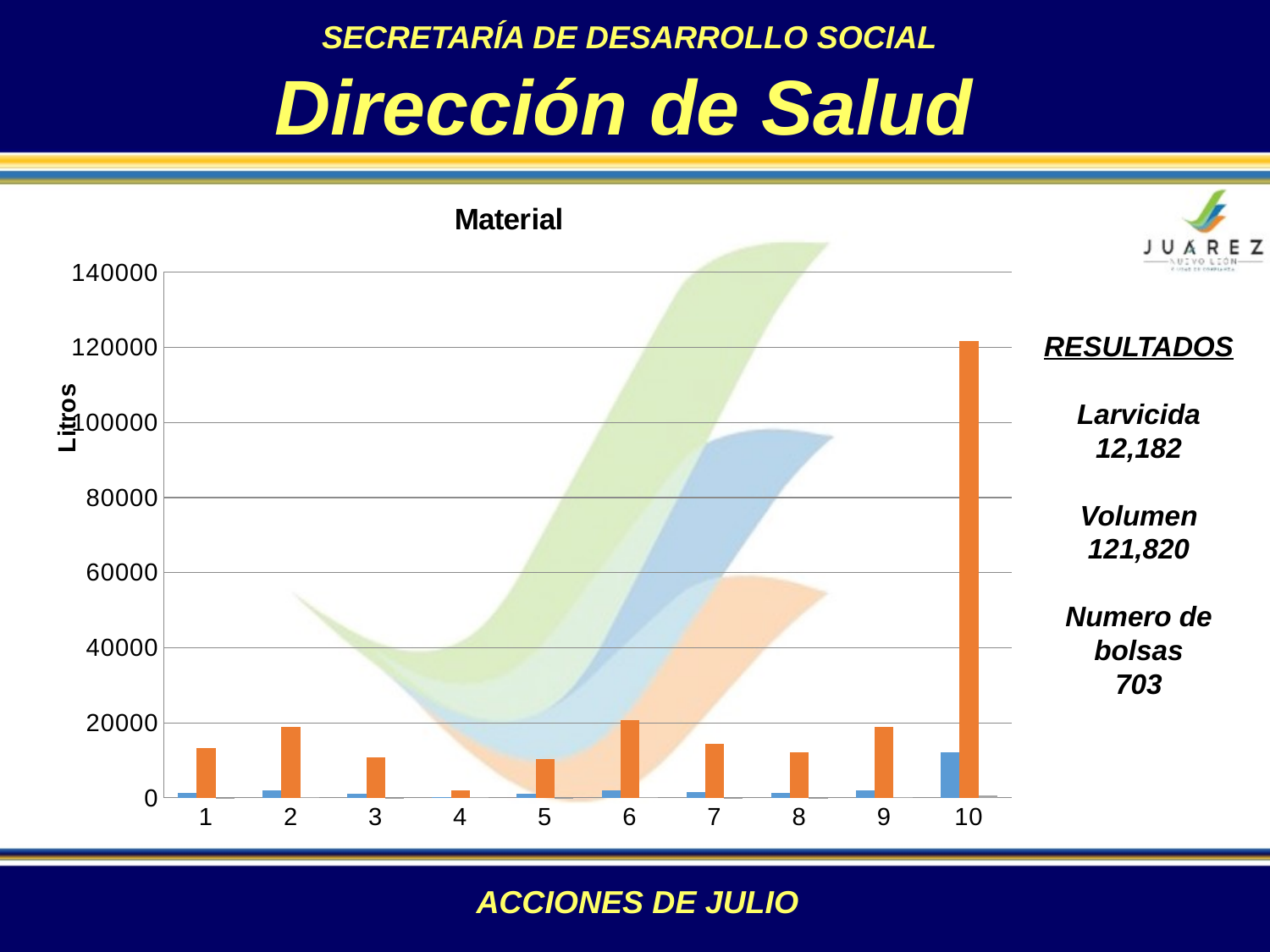
Which is larger, the orange bar for category 2 or the orange bar for category 4? category 2 Which category has the tallest blue bar? 10 Which category has the shortest orange bar? 4 Is the orange bar for category 4 greater or less than 20000? less How many categories are shown along the x axis of the chart? 10 Which is larger, the orange bar for category 6 or the orange bar for category 5? category 6 Is the orange bar for category 10 greater or less than 100000? greater What is the title of the chart? Material What kind of chart is shown on the slide? bar chart Which category has the tallest orange bar? 10 Is the blue bar for category 10 greater or less than 20000? less What is the label on the vertical axis of the chart? Litros